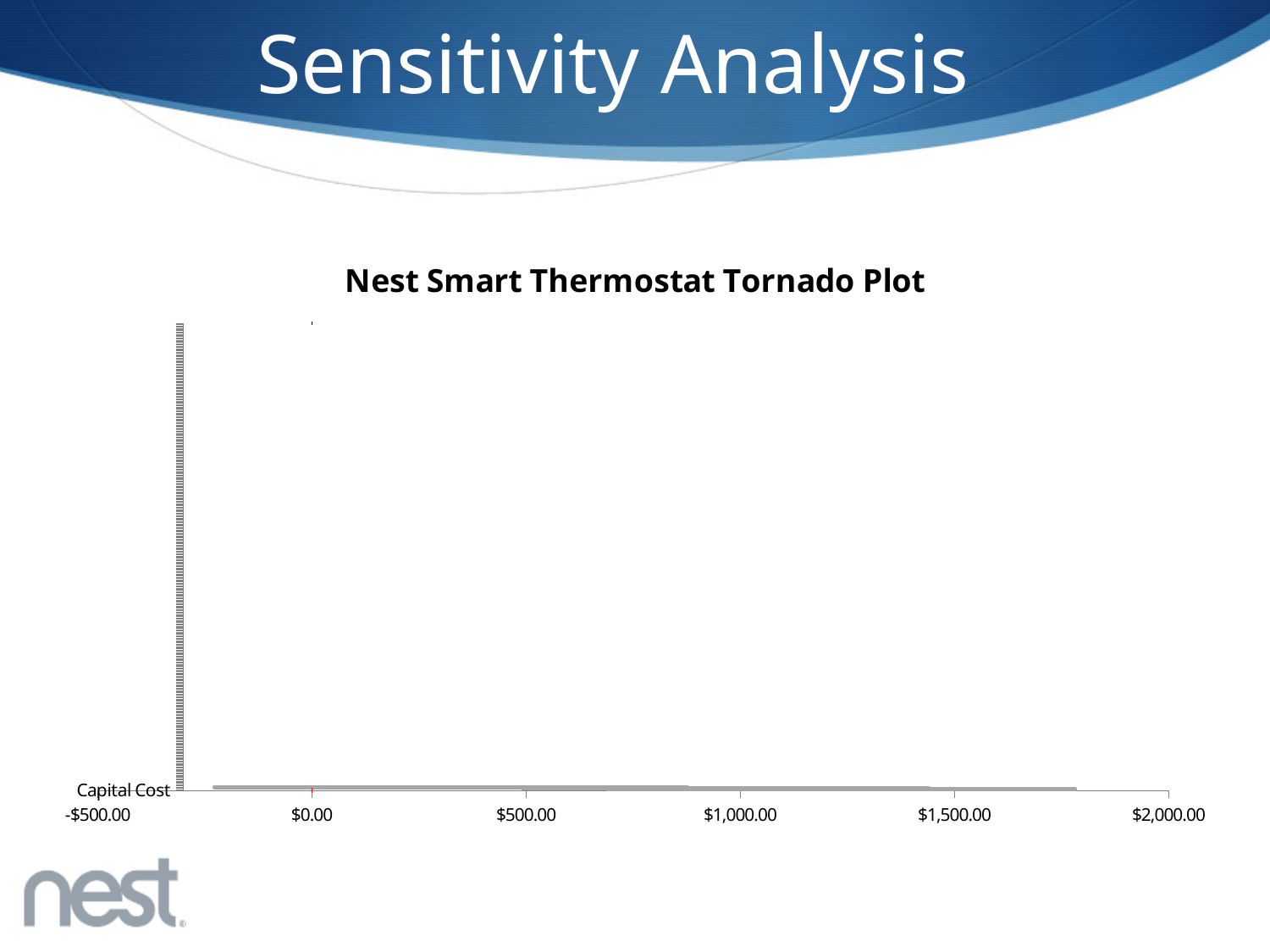
What is the title of the chart on the slide? Nest Smart Thermostat Tornado Plot What kind of chart is the Nest Smart Thermostat Tornado Plot? bar chart In the Nest Smart Thermostat Tornado Plot, which category label is readable at the bottom of the vertical axis? Capital Cost In the Nest Smart Thermostat Tornado Plot, does the right end of the Capital Cost bar reach a value greater or less than $1,500.00? greater